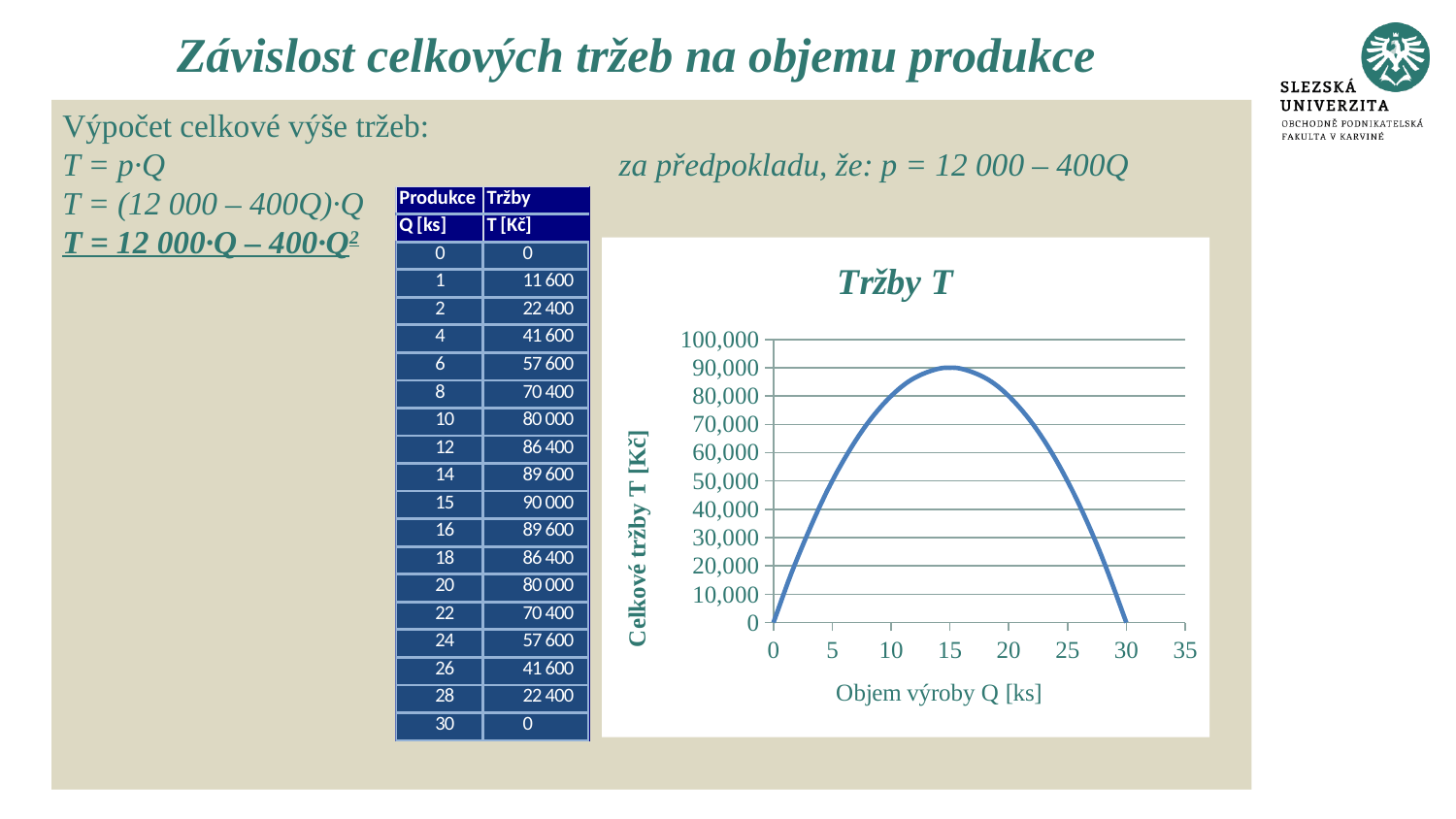
Does the curve rise or fall as Q increases from 0 to 15? rise Which is larger, the value of T at Q = 10 or at Q = 25? Q = 10 Is the value of T at Q = 25 greater or less than 60,000? less Does the curve rise or fall as Q increases from 15 to 30? fall What is the value of T at Q = 0? 0 Is the value of T at Q = 10 greater or less than 70,000? greater What is the value of T at Q = 30? 0 At which value of Q does the curve reach its highest point? 15 What is the label of the horizontal axis of the chart? Objem výroby Q [ks] What is the value of T at the peak of the curve (Q = 15)? 90,000 What kind of chart is shown on the slide? line chart What is the title of the chart? Tržby T